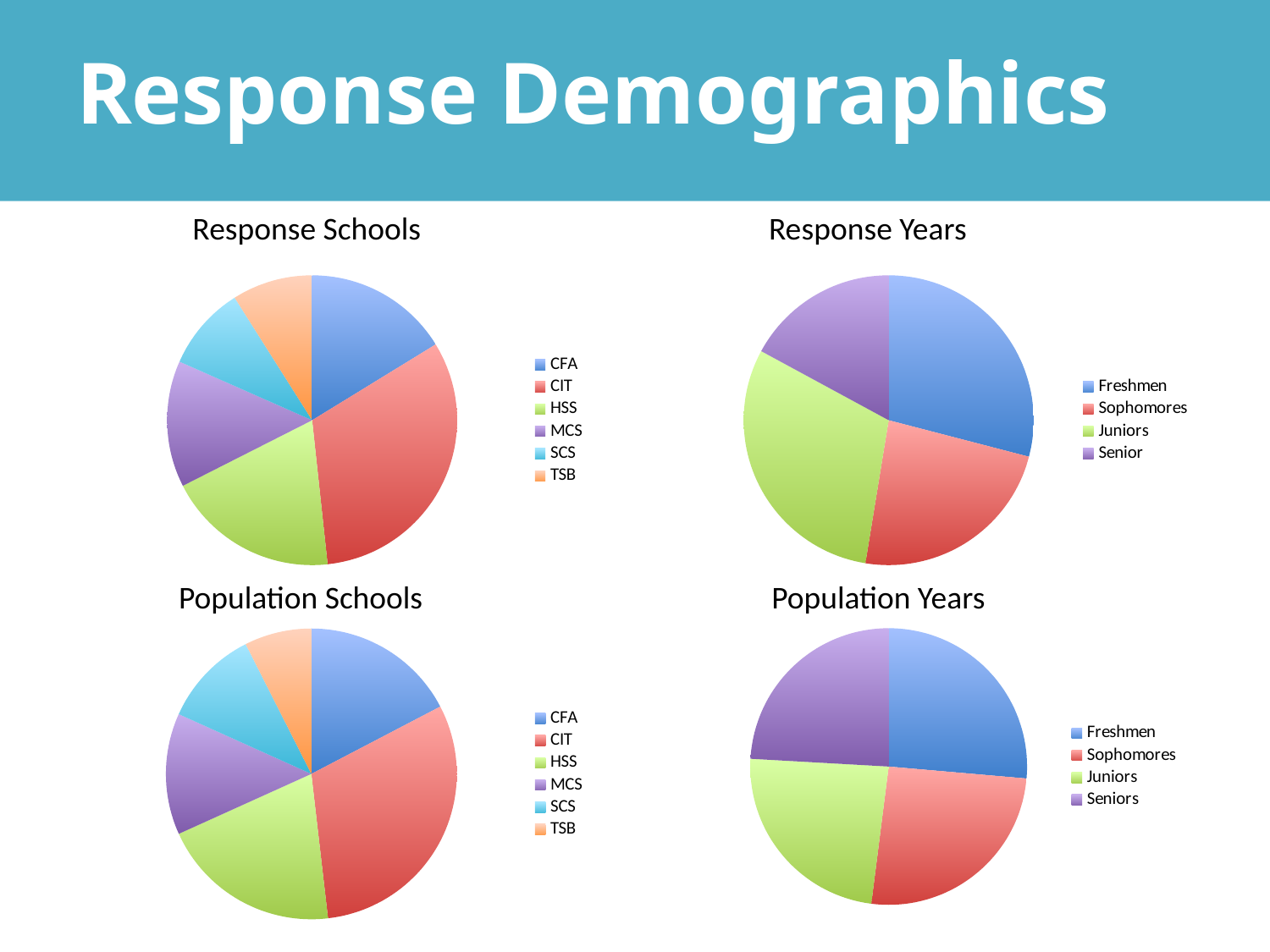
How many pie charts are shown on the slide? 4 In the Response Schools chart, which slice is larger, CIT or CFA? CIT In the Population Schools chart, which school has the smallest slice? TSB In the Response Years chart, which slice is larger, Juniors or Senior? Juniors What is the title of the chart in the bottom-right of the slide? Population Years In the Population Schools chart, which school has the largest slice? CIT How many categories does the legend of the Response Schools chart list? 6 What kind of chart is the Response Schools chart? pie chart In the Population Schools chart, which slice is larger, HSS or MCS? HSS How many categories does the legend of the Response Years chart list? 4 In the Response Years chart, which year has the smallest slice? Senior In the Response Schools chart, which school has the largest slice? CIT